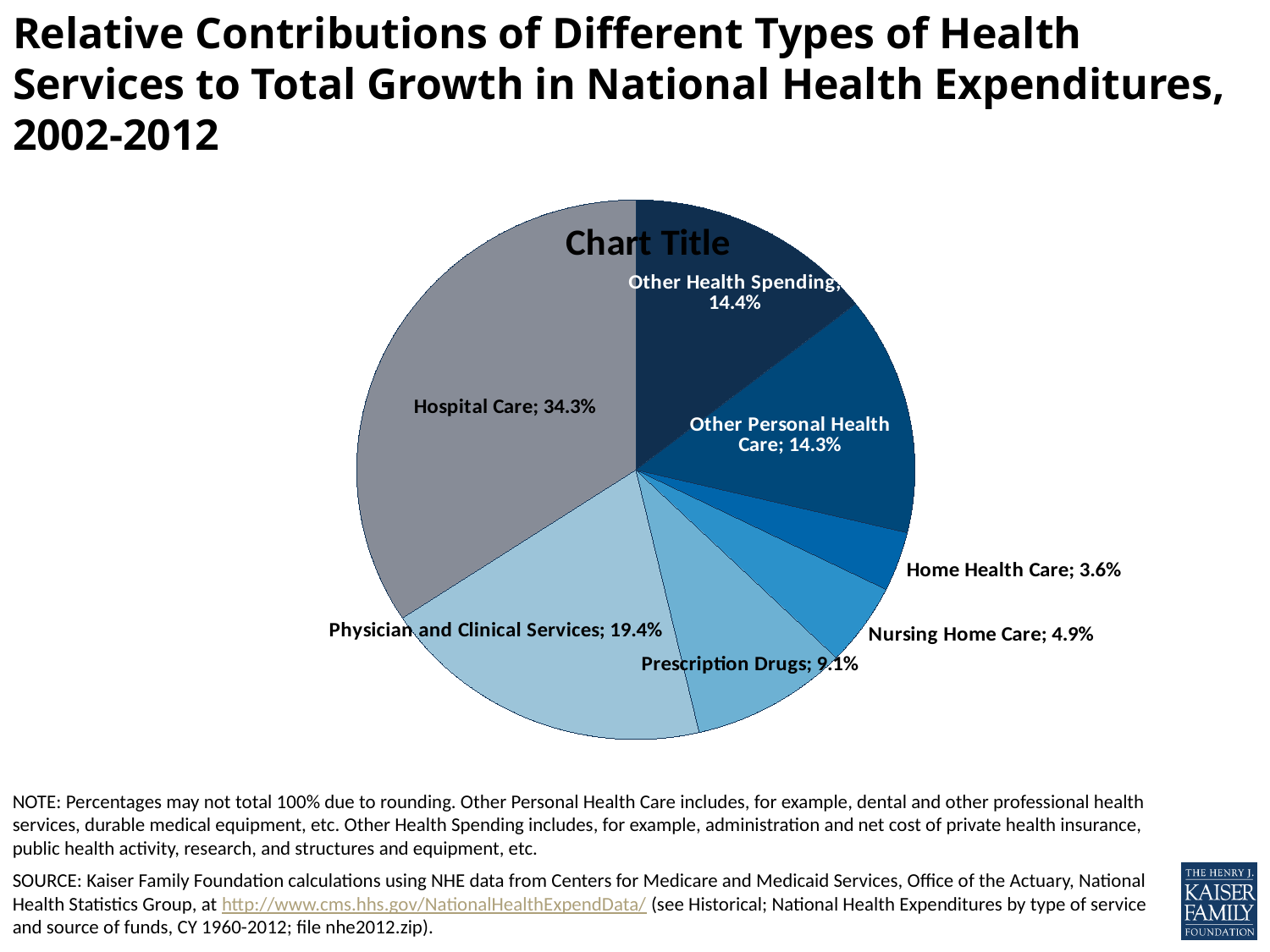
What percentage of total growth is attributed to Hospital Care? 34.3% What type of chart is shown on the slide? Pie chart What is the value shown for Physician and Clinical Services? 19.4% What is the combined share of Nursing Home Care and Home Health Care? 8.5% Which category has the largest slice of the pie? Hospital Care What share does Prescription Drugs contribute according to the pie chart? 9.1% What is the value labelled for Home Health Care? 3.6% Which is larger: Prescription Drugs or Nursing Home Care? Prescription Drugs What is the difference in percentage points between Hospital Care and Physician and Clinical Services? 14.9 Which category has the smallest slice of the pie? Home Health Care What percentage is shown for Nursing Home Care? 4.9% How many slices does the pie chart have? 7